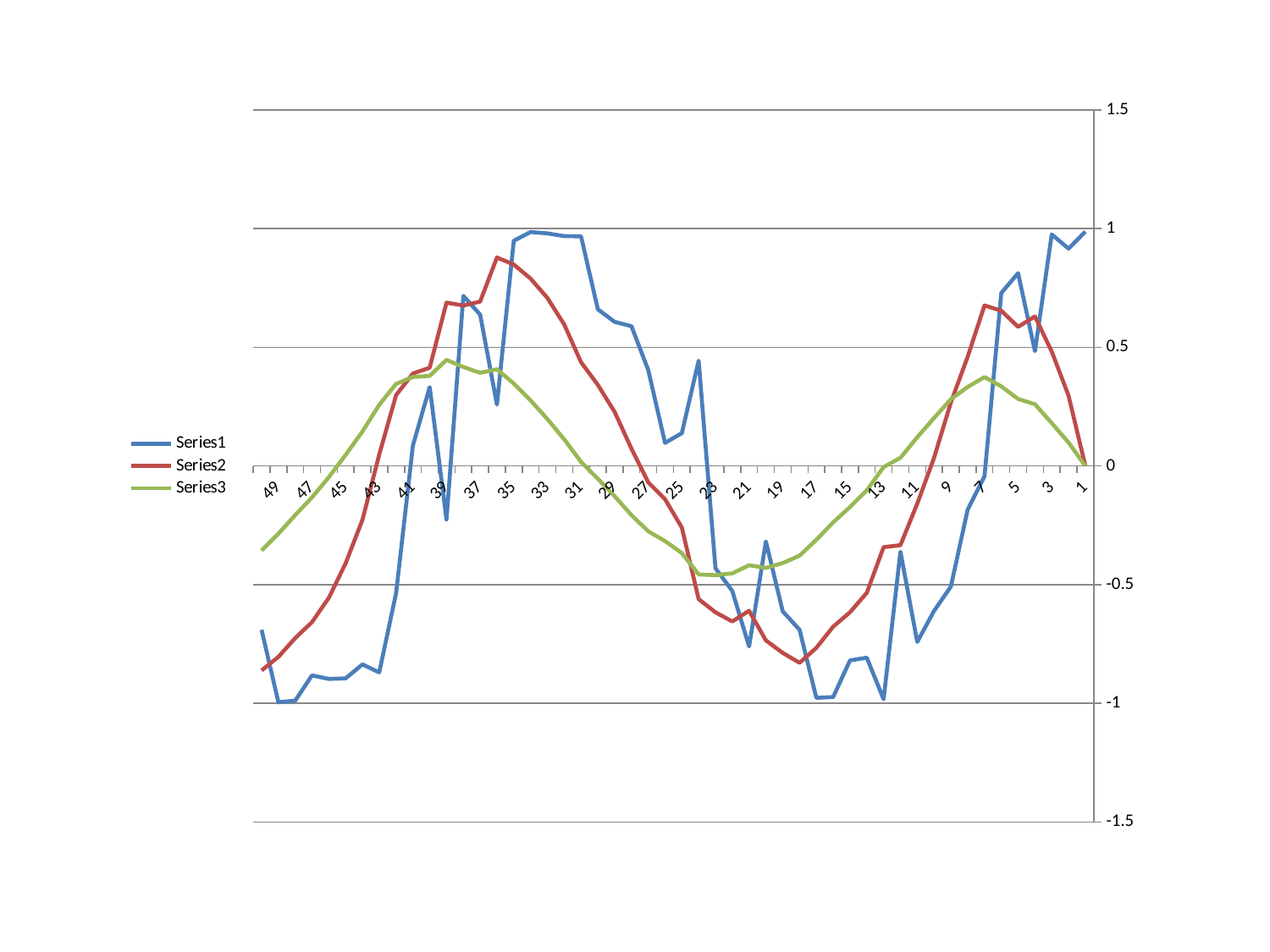
What is the highest value shown on the vertical axis? 1.5 At x = 35, which is larger: Series1 or Series3? Series1 What are the names of the series listed in the legend? Series1, Series2, Series3 Is the value of Series1 at x = 49 greater or less than -0.5? less Is the value of Series1 at x = 17 greater or less than -0.5? less How many series does the legend list? 3 Does Series2 rise or fall between x = 35 and x = 17? fall What kind of chart is shown on the slide? line chart At x = 49, which is larger: Series1 or Series3? Series3 Is the value of Series3 at x = 49 greater or less than -0.5? greater